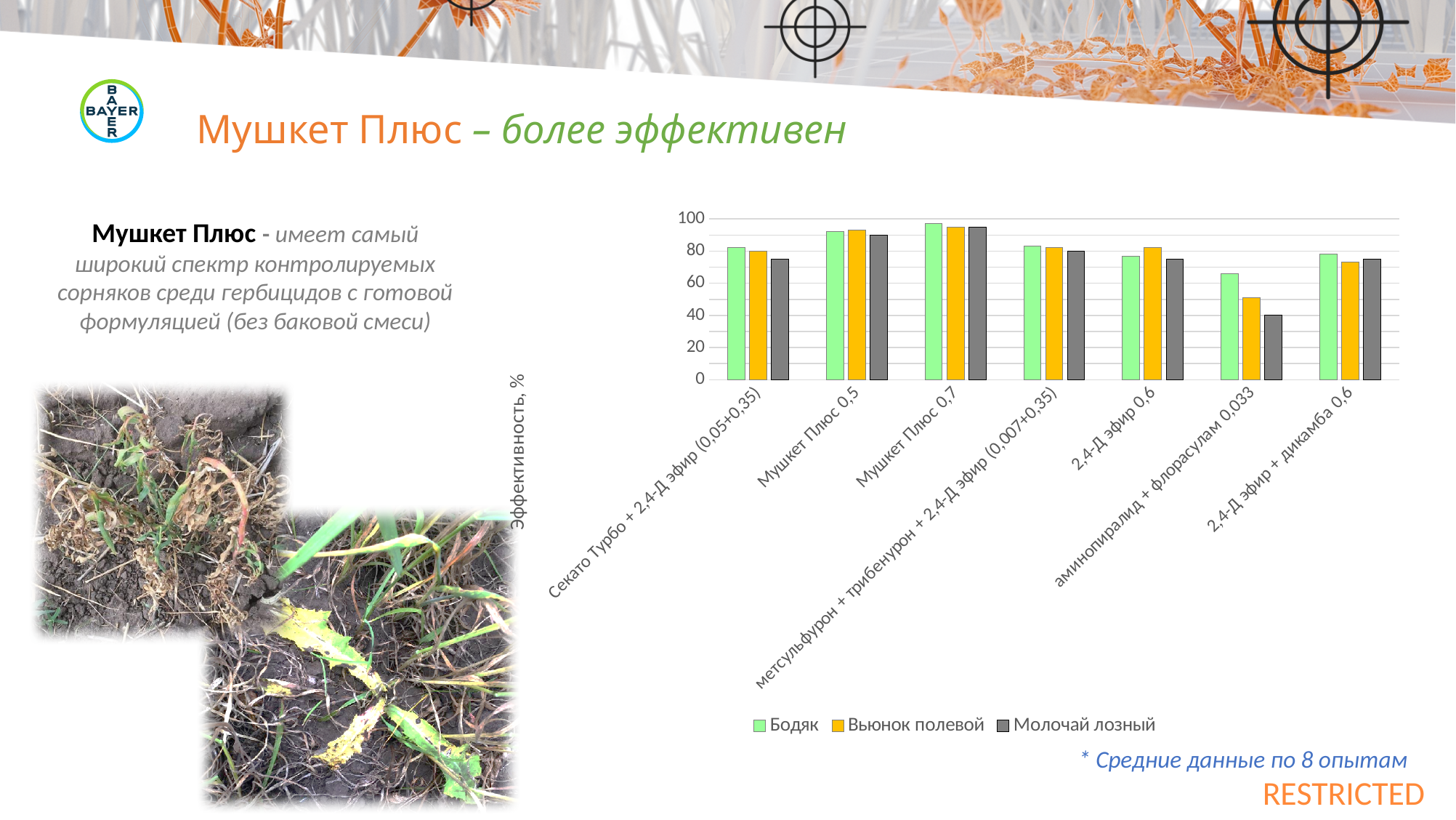
How many herbicide treatments (categories) are shown on the x axis of the chart? 7 For which treatment is the Бодяк value highest? Мушкет Плюс 0,7 What kind of chart is shown on the slide? bar chart For which treatment is the Молочай лозный value lowest? аминопиралид + флорасулам 0,033 Which series are listed in the chart legend? Бодяк, Вьюнок полевой, Молочай лозный Is the Вьюнок полевой value for аминопиралид + флорасулам 0,033 greater or less than 60? less For which treatment is the Вьюнок полевой value lowest? аминопиралид + флорасулам 0,033 How many series does the chart legend list? 3 Is the Бодяк value for Мушкет Плюс 0,7 greater or less than 80? greater Is the Молочай лозный value for аминопиралид + флорасулам 0,033 greater or less than 60? less For аминопиралид + флорасулам 0,033, which is larger: the Бодяк value or the Молочай лозный value? Бодяк What is the label of the vertical axis of the chart? Эффективность, %